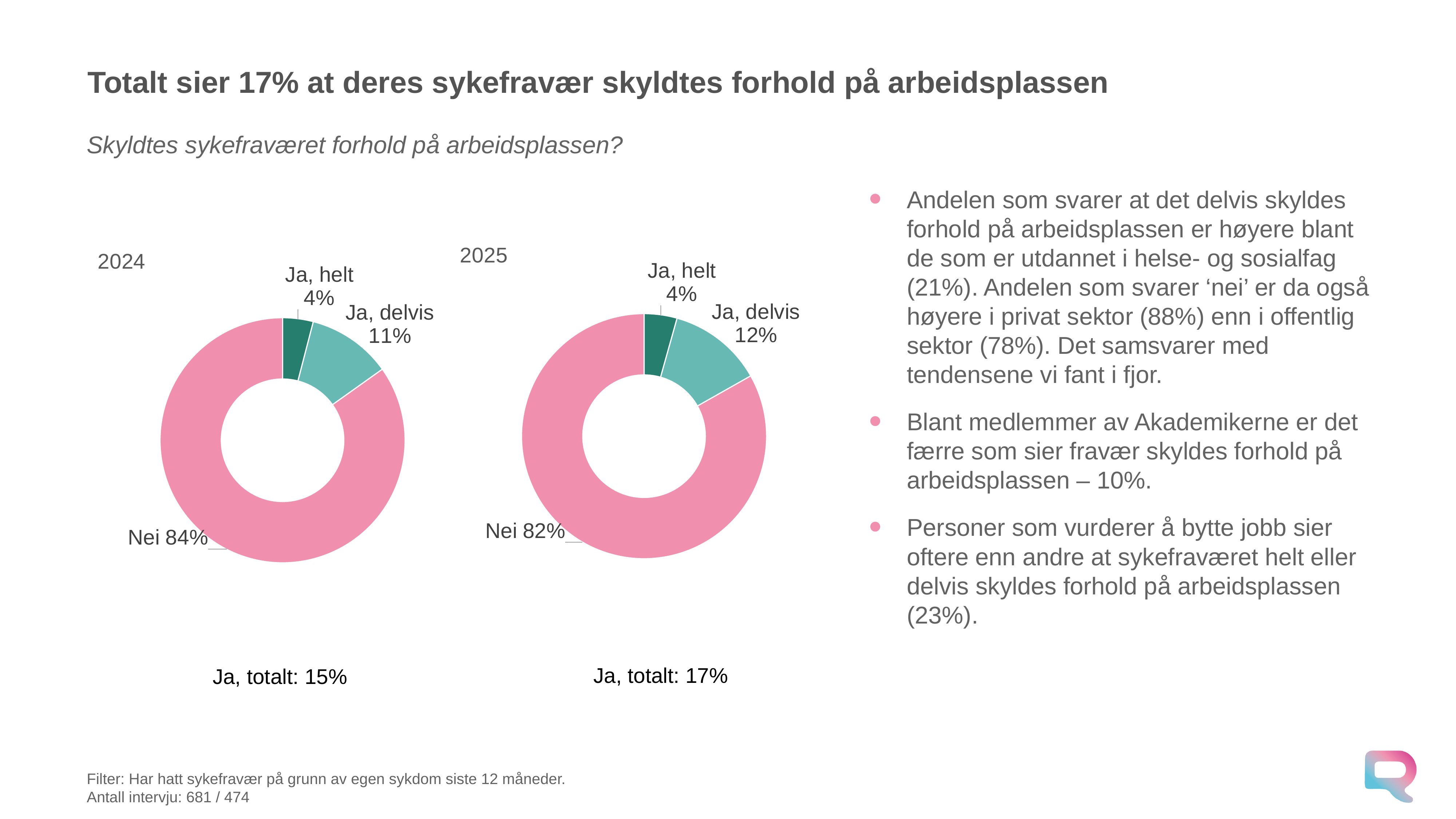
In the 2024 chart, what share of respondents answered 'Ja, delvis'? 11% In the 2025 chart, what share of respondents answered 'Ja, helt'? 4% What is the 'Ja, totalt' value shown below the 2025 chart? 17% In the 2024 chart, what share of respondents answered 'Nei'? 84% What is the difference between the 'Nei' share in the 2024 chart and the 'Nei' share in the 2025 chart? 2 percentage points In the 2025 chart, what share of respondents answered 'Ja, delvis'? 12% In the 2024 chart, which category has the smallest share? Ja, helt Which is larger: 'Ja, delvis' in the 2024 chart or 'Ja, delvis' in the 2025 chart? 2025 In the 2025 chart, which category has the largest share? Nei What kind of chart is used to show the 2024 and 2025 results? Donut (pie) chart What colour is the 'Nei' segment in both charts? Pink How many categories does each donut chart show? 3